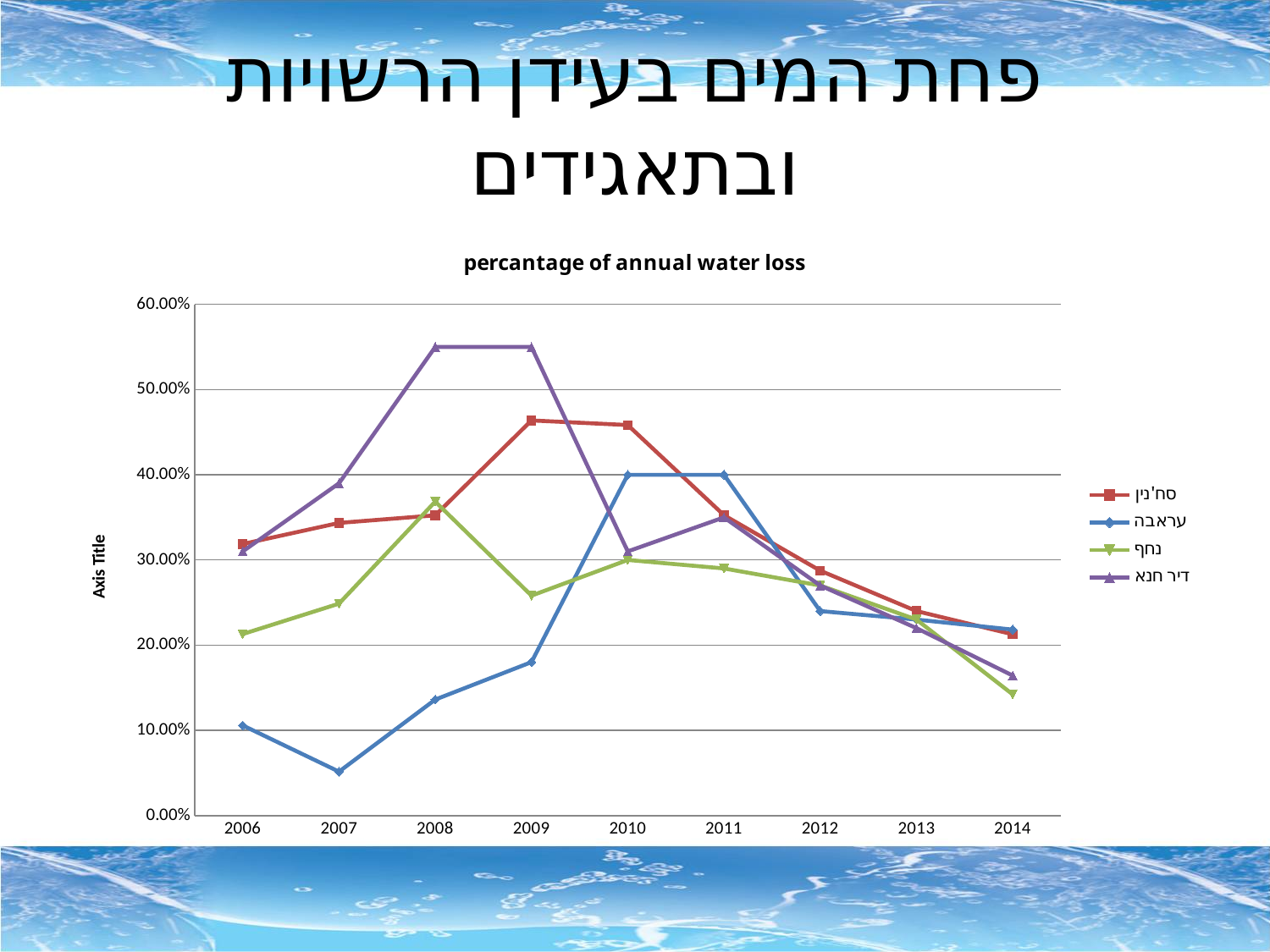
Is the value for עראבה in 2007 greater or less than 10.00%? less Is the value for דיר חנא in 2008 greater or less than 50.00%? greater What is the title of the chart? percantage of annual water loss Which series has the highest value in 2008? דיר חנא How many series does the legend list? 4 In which year is the value for עראבה lowest? 2007 Is the value for סח'נין in 2009 greater or less than 40.00%? greater What kind of chart is shown on the slide? line chart Which series has the lowest value in 2014? נחף Which is larger in 2011, the value for סח'נין or the value for עראבה? עראבה How many years are shown on the x axis? 9